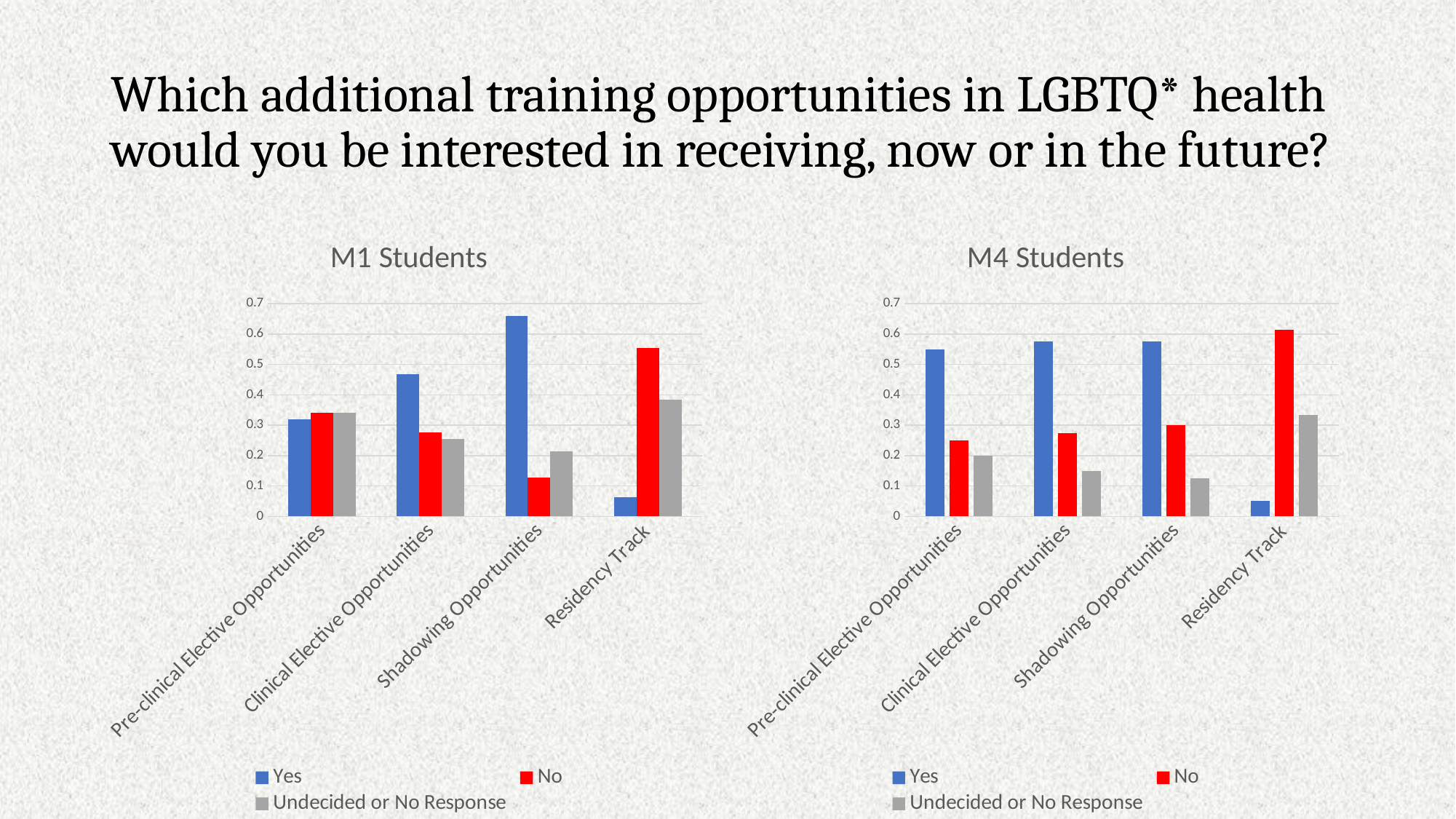
In the M4 Students chart, which category has the lowest Yes value? Residency Track In the M4 Students chart, which category has the highest No value? Residency Track In the M1 Students chart, for Residency Track, which is larger: the Yes value or the No value? No In the M1 Students chart, which category has the lowest Yes value? Residency Track In the M1 Students chart, which category has the highest Yes value? Shadowing Opportunities How many series does the legend of the M1 Students chart list? 3 In the M1 Students chart, is the Yes value for Shadowing Opportunities greater or less than 0.6? greater In the M4 Students chart, for Residency Track, which is larger: the No value or the Undecided or No Response value? No What kind of chart is the M1 Students chart? bar chart How many categories are shown on the x axis of the M4 Students chart? 4 In the M4 Students chart, is the Yes value for Pre-clinical Elective Opportunities greater or less than 0.5? greater In the M4 Students chart, what colour represents the No series? red